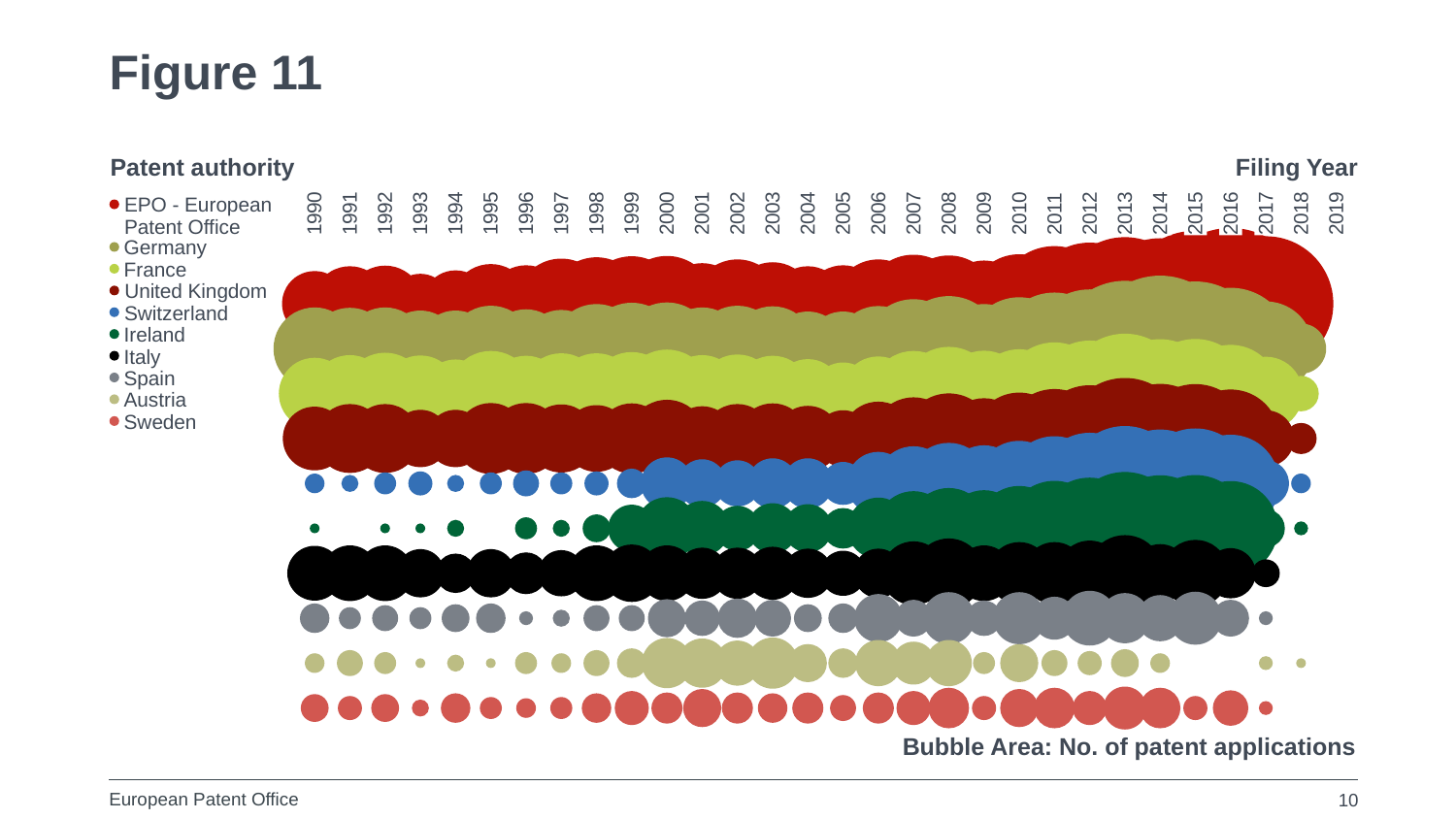
Do the bubbles for Switzerland get larger or smaller from 1990 to 2015? Larger What is the latest filing year shown on the x axis? 2019 Which patent authority has the largest bubbles overall? EPO - European Patent Office What kind of chart is shown on the slide? Bubble chart Which is larger for Switzerland: the bubble for 1990 or the bubble for 2010? 2010 Do the bubbles for Ireland get larger or smaller from 1990 to 2013? Larger What is the earliest filing year shown on the x axis? 1990 How many filing years are shown along the x axis? 30 How many patent authorities does the legend list? 10 What colour are the bubbles for Italy? Black What does the bubble area represent? No. of patent applications Which is larger for Ireland: the bubble for 1990 or the bubble for 2012? 2012